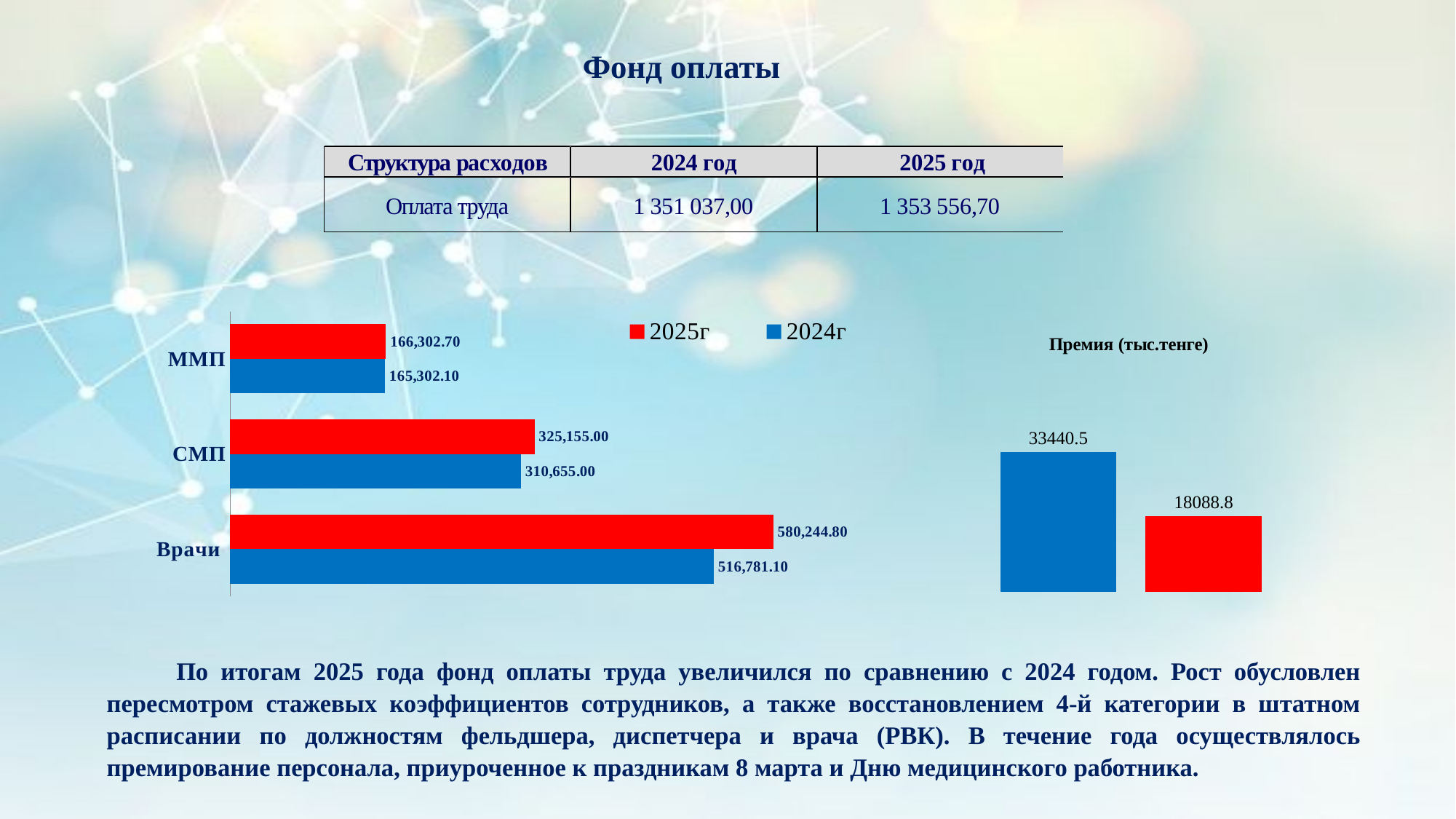
In the left bar chart, what is the difference between the 2025г and 2024г values for СМП? 14,500.00 How many series does the legend of the left bar chart list? 2 How many categories are shown in the left bar chart? 3 In the left bar chart, what is the value for ММП in the 2025г series? 166,302.70 In the left bar chart, which category has the highest value in the 2024г series? Врачи In the left bar chart, what is the value for Врачи in the 2025г series? 580,244.80 In the chart titled Премия (тыс.тенге), what is the value of the left (blue) bar? 33440.5 In the chart titled Премия (тыс.тенге), what is the difference between the two bars? 15351.7 In the left bar chart, what is the difference between the 2025г and 2024г values for Врачи? 63,463.70 In the left bar chart, what is the value for СМП in the 2024г series? 310,655.00 In the left bar chart, which is larger for СМП: the 2025г value or the 2024г value? 2025г In the left bar chart, which category has the lowest value in the 2025г series? ММП